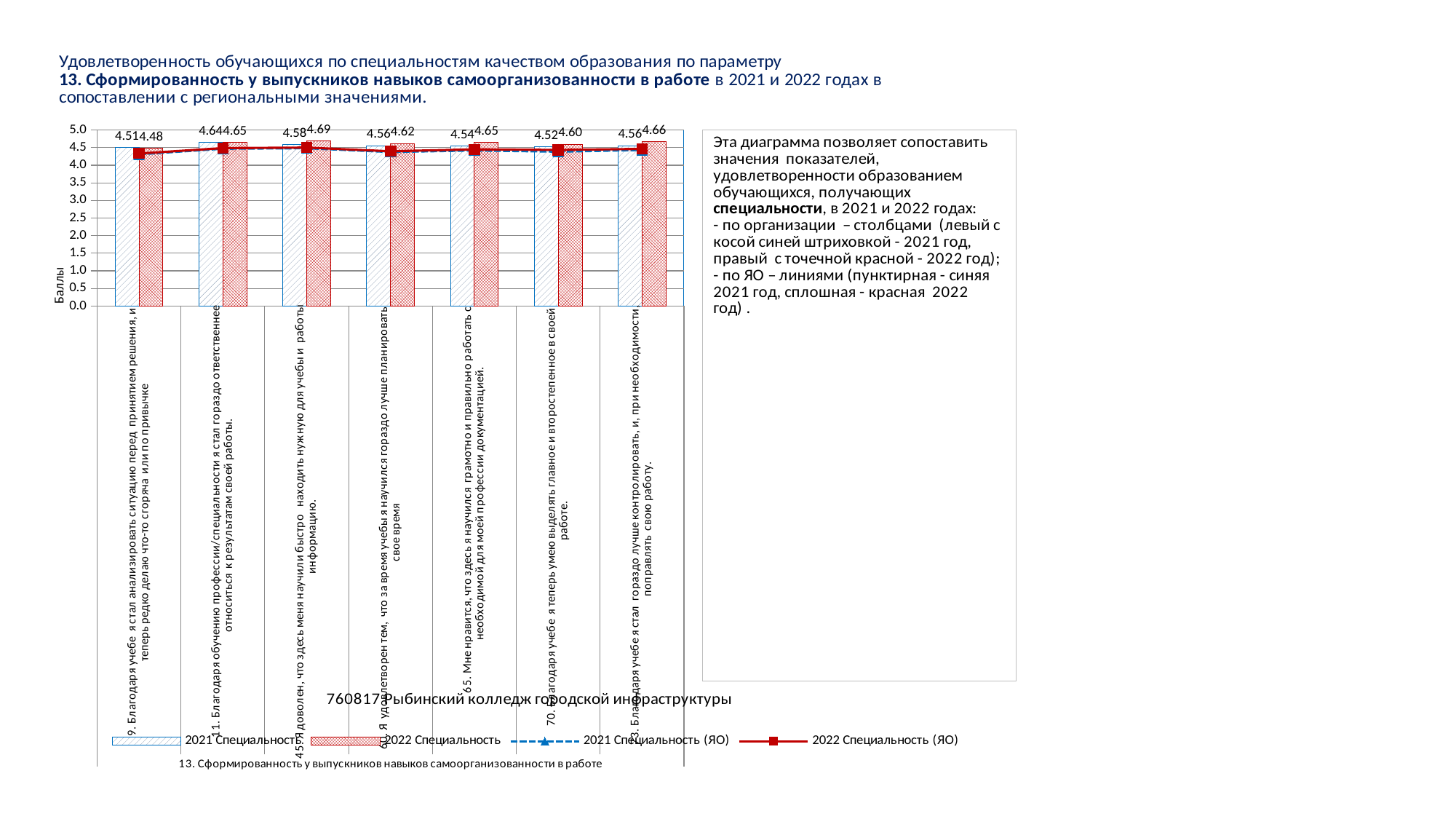
How many categories (questions) are shown on the x axis of the chart? 7 What type of chart is used to show the Специальность values for 2021 and 2022? bar chart What is the label of the vertical axis of the chart? Баллы What is the value of the 2022 Специальность bar for category 45 ("45. Я доволен, что здесь меня научили быстро находить нужную для учебы и работы информацию")? 4.69 What is the difference between the 2022 and 2021 Специальность values for category 45? 0.11 Which category has the lowest 2022 Специальность value? 9. Благодаря учебе я стал анализировать ситуацию перед принятием решения... (4.48) Which category has the highest 2022 Специальность value? 45. Я доволен, что здесь меня научили быстро находить нужную для учебы и работы информацию (4.69) What is the value of the 2021 Специальность bar for category 9 ("9. Благодаря учебе я стал анализировать ситуацию перед принятием решения...")? 4.51 Which category has the highest 2021 Специальность value? 11. Благодаря обучению профессии/специальности я стал гораздо ответственнее относиться к результатам своей работы (4.64) What is the value of the 2022 Специальность bar for category 70 ("70. Благодаря учебе я теперь умею выделять главное и второстепенное в своей работе")? 4.60 How many series does the chart legend list? 4 For category 9, which is larger: the 2021 Специальность value or the 2022 Специальность value? 2021 Специальность (4.51)